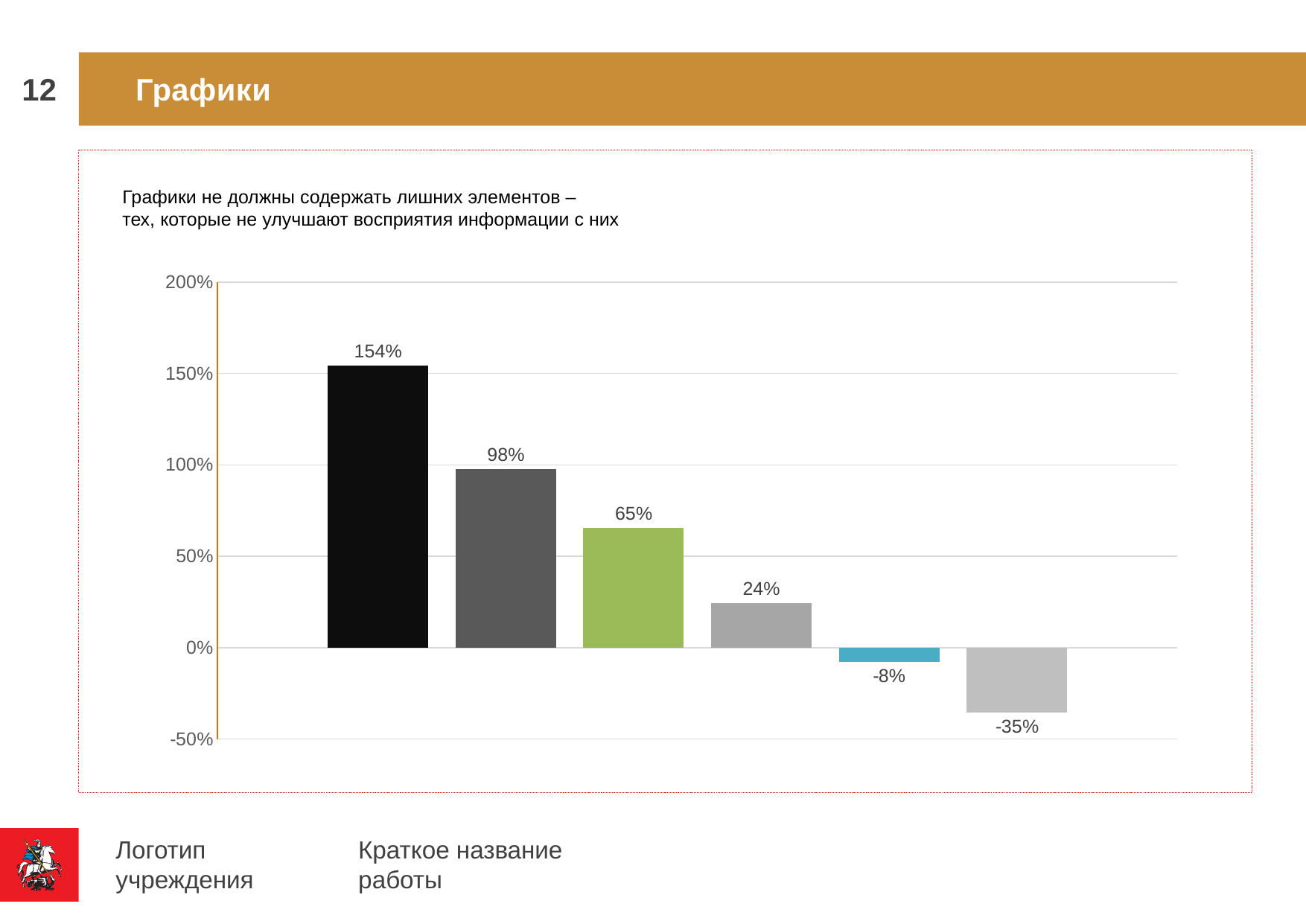
What is the difference between the first bar (154%) and the second bar (98%)? 56% Which is larger, the value of the green bar or the value of the fourth bar? the green bar (65%) How many bars does the chart contain? 6 What is the lowest value shown on the chart? -35% What is the value shown on the blue bar? -8% How many bars on the chart have negative values? 2 What is the value shown on the first (black) bar? 154% What is the value shown on the last bar on the right? -35% What kind of chart is shown on the slide? bar chart What is the value shown on the green bar? 65% What is the highest value shown on the chart? 154% Do the bar values rise or fall from left to right across the chart? fall